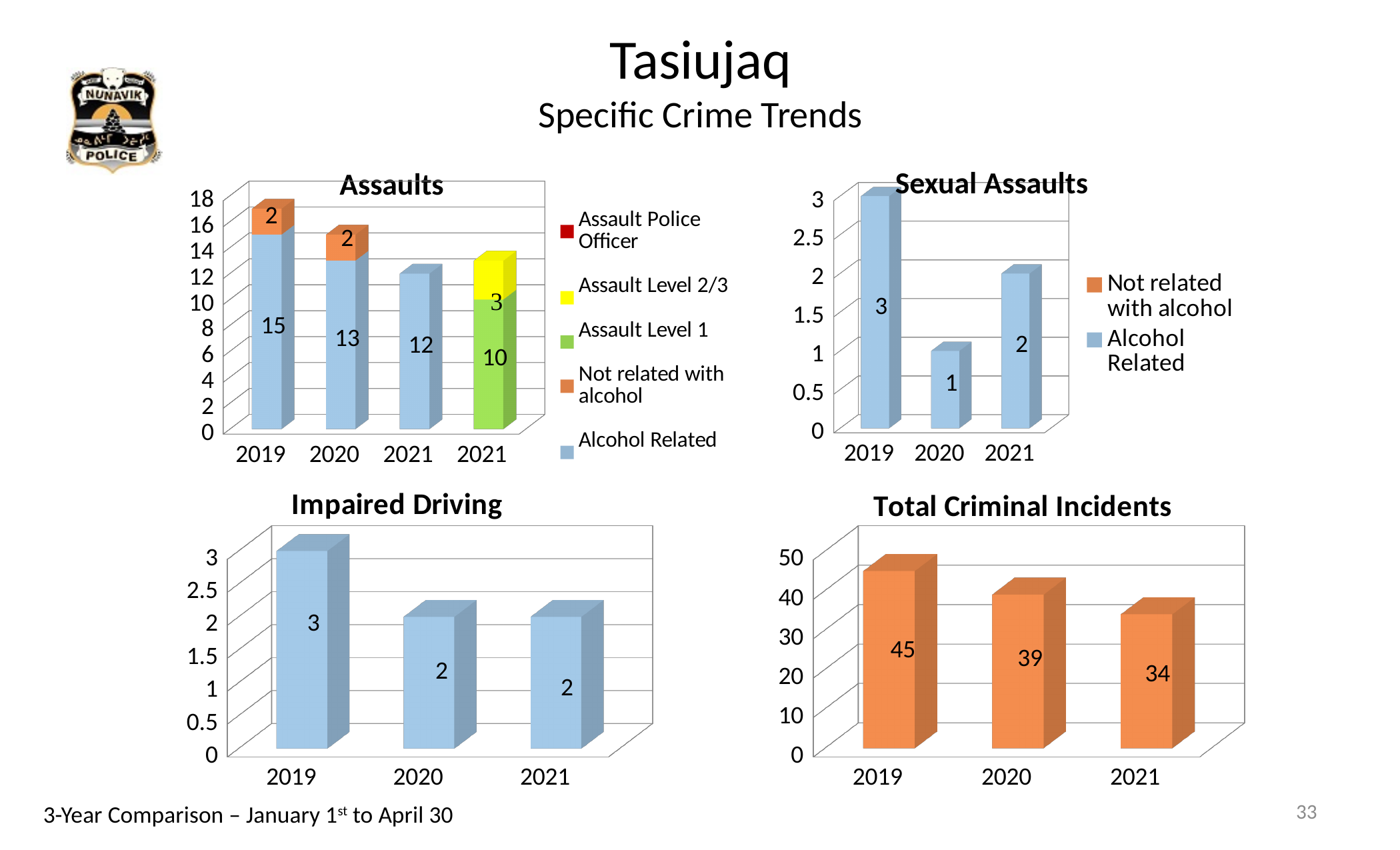
In the Total Criminal Incidents chart, what is the difference between 2019 and 2021? 11 In the Sexual Assaults chart, how many series does the legend list? 2 In the Total Criminal Incidents chart, what is the value for 2019? 45 What kind of chart is the Total Criminal Incidents chart? bar chart In the Impaired Driving chart, what is the value for 2019? 3 In the Impaired Driving chart, how many years are shown on the x axis? 3 In the Sexual Assaults chart, which year has the highest value? 2019 In the Assaults chart, what is the Alcohol Related value for 2020? 13 In the Total Criminal Incidents chart, which year has the lowest value? 2021 In the Total Criminal Incidents chart, do the values rise or fall from 2019 to 2021? fall In the Assaults chart, what is the total of the stacked bar for 2019? 17 In the Sexual Assaults chart, what is the value for 2020? 1